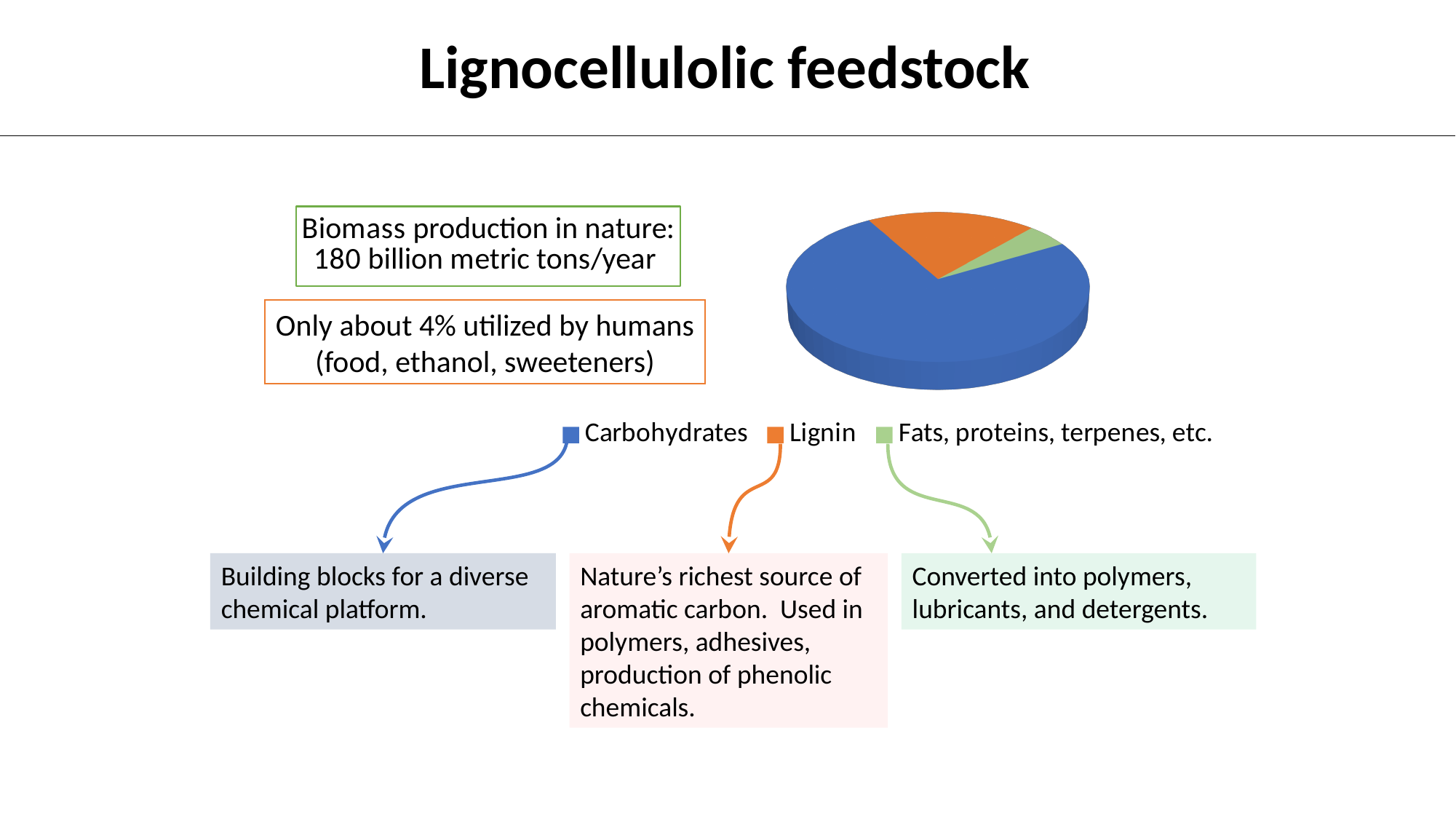
Which category has the largest slice of the pie chart? Carbohydrates How many slices does the pie chart have? 3 What kind of chart is shown on the slide? pie chart Is the Carbohydrates slice more or less than half of the pie? more Which slice is larger: Lignin or Fats, proteins, terpenes, etc.? Lignin What colour represents Lignin in the pie chart? orange Which category has the second-largest slice of the pie chart? Lignin What colour represents Carbohydrates in the pie chart? blue How many entries does the legend of the pie chart list? 3 Which category has the smallest slice of the pie chart? Fats, proteins, terpenes, etc. Which slice is larger: Carbohydrates or Lignin? Carbohydrates